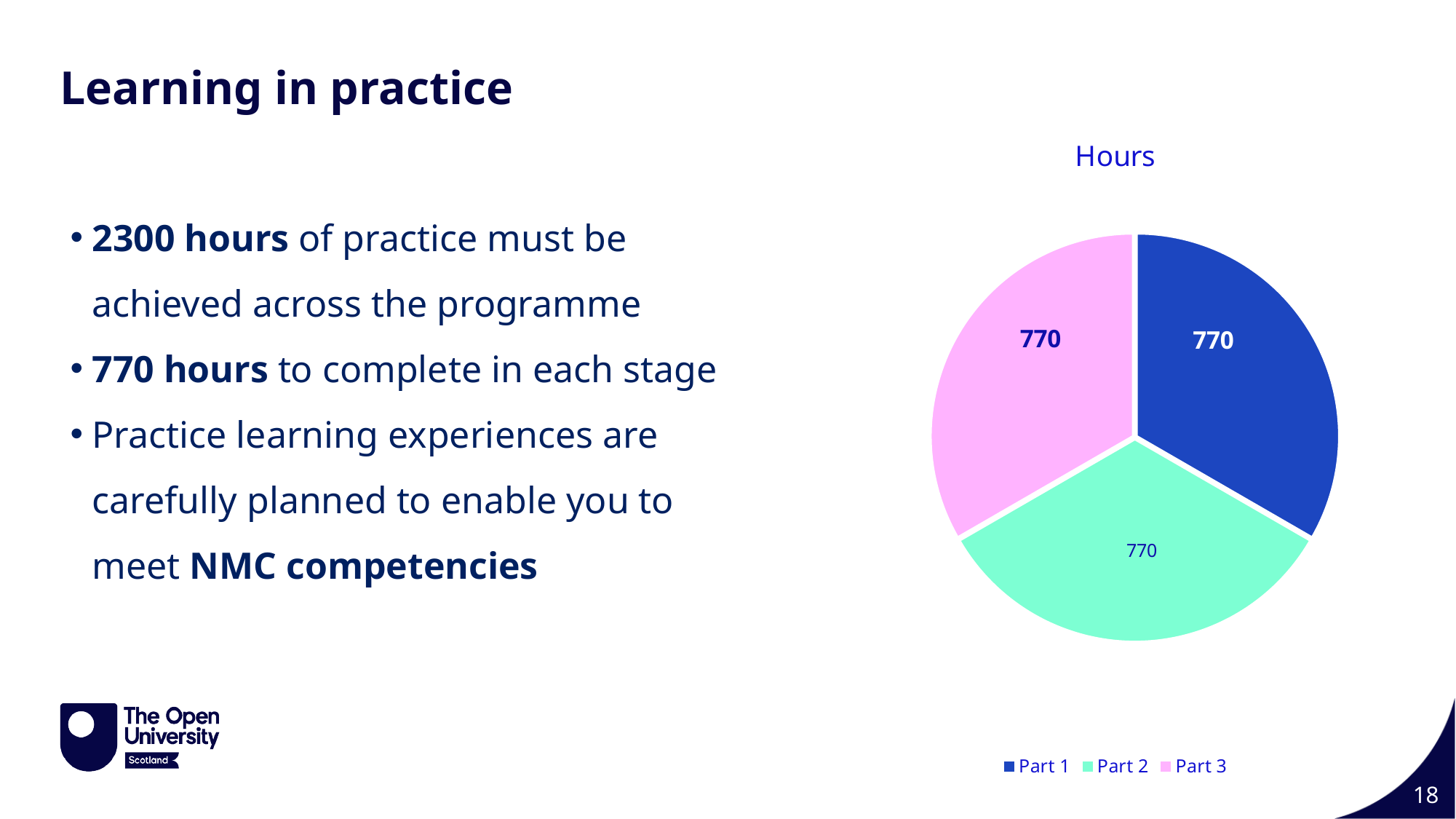
What is the value for Part 2 in the pie chart? 770 What is the difference between the values for Part 1 and Part 3 in the pie chart? 0 How many entries does the legend of the pie chart list? 3 Which colour represents Part 3 in the pie chart? pink What is the value for Part 3 in the pie chart? 770 What share of the pie chart does Part 2 represent? one third What is the title of the pie chart? Hours How many slices does the pie chart have? 3 What kind of chart is shown on the slide? pie chart What is the total of all slices in the pie chart? 2310 What is the value for Part 1 in the pie chart? 770